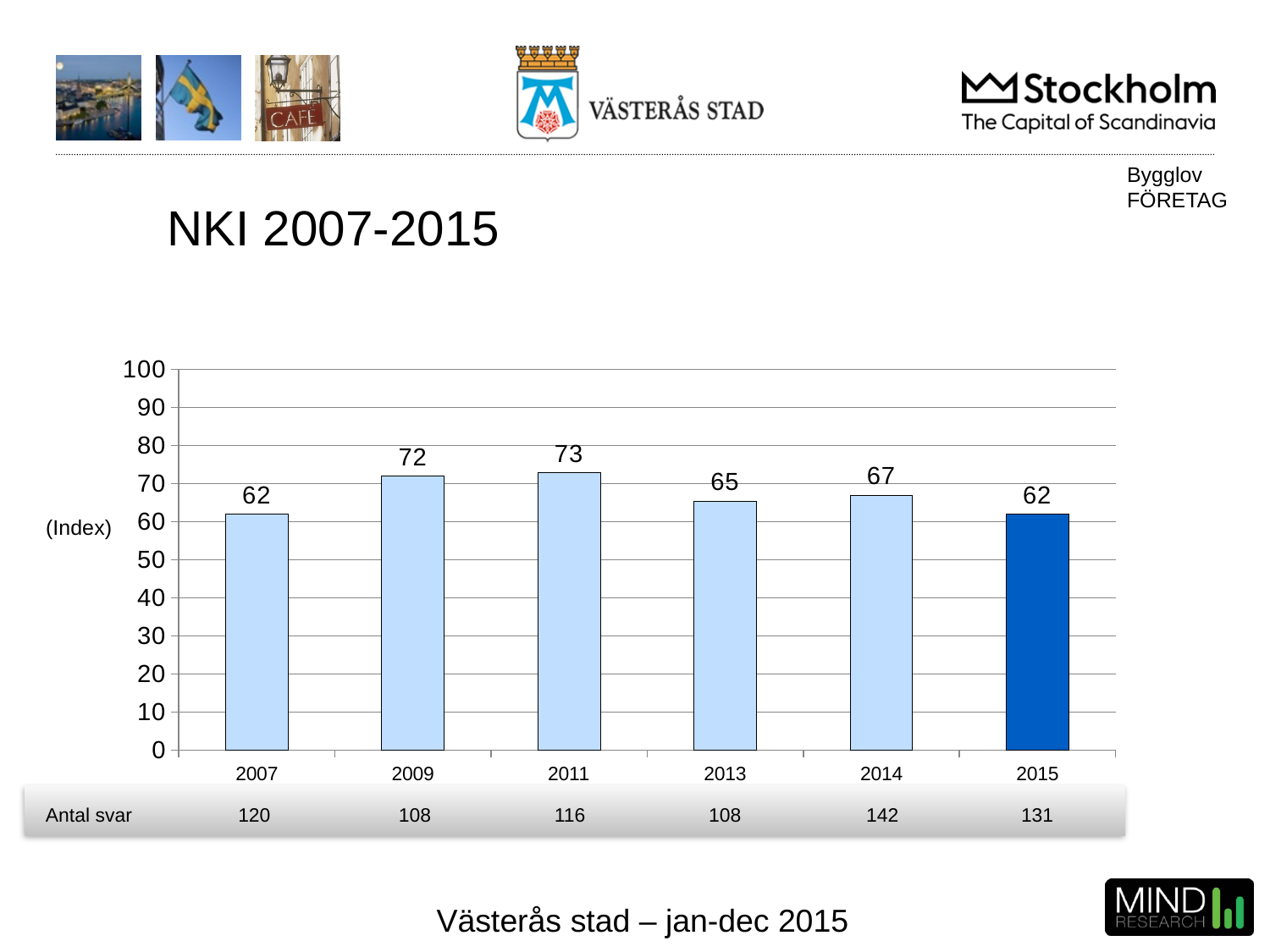
Which bar is shown in a darker blue colour than the others? 2015 What is the title of the chart? NKI 2007-2015 What is the NKI index value for 2015? 62 How many years are shown on the x axis of the chart? 6 What kind of chart is shown on the slide? bar chart What is the difference between the NKI index values for 2009 and 2013? 7 What is the NKI index value for 2014? 67 Does the NKI index value rise or fall from 2011 to 2013? fall Which is larger, the NKI index value for 2013 or for 2014? 2014 What is the difference between the NKI index values for 2011 and 2015? 11 What is the NKI index value for 2011? 73 Which year has the highest NKI index value? 2011